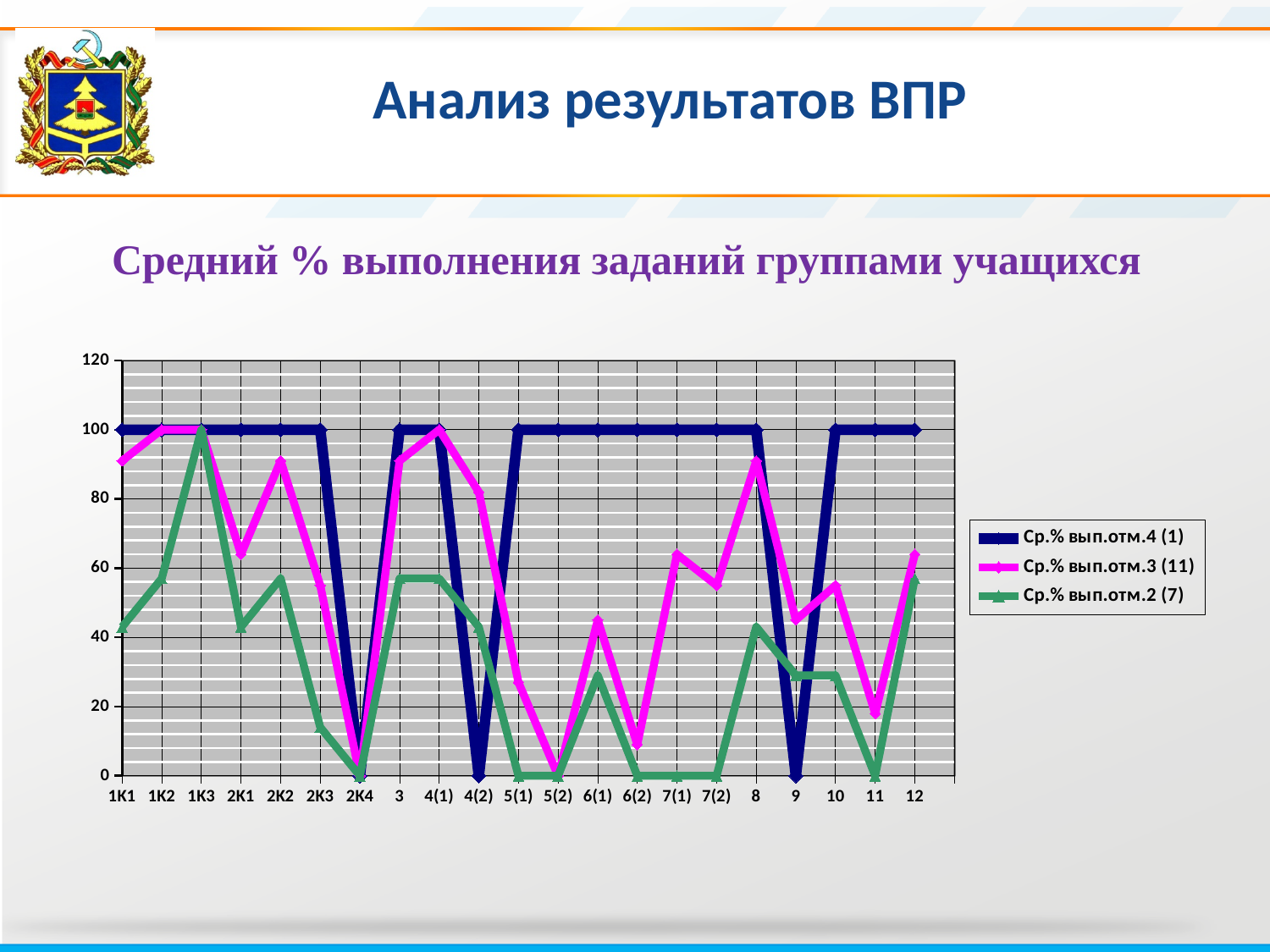
At 2К1, which series has the larger value: Ср.% вып.отм.3 (11) or Ср.% вып.отм.2 (7)? Ср.% вып.отм.3 (11) What is the value of Ср.% вып.отм.2 (7) at 2К4? 0 What is the value of Ср.% вып.отм.4 (1) at 9? 0 How many series does the legend list? 3 What is the title shown above the chart? Средний % выполнения заданий группами учащихся Is the value of Ср.% вып.отм.2 (7) at 8 greater or less than 60? less What is the value of Ср.% вып.отм.4 (1) at 1К1? 100 What is the value of Ср.% вып.отм.3 (11) at 1К3? 100 What kind of chart is shown on the slide? line chart Is the value of Ср.% вып.отм.3 (11) at 1К1 greater or less than 80? greater How many categories are shown on the x axis? 21 At 7(1), which series has the larger value: Ср.% вып.отм.3 (11) or Ср.% вып.отм.2 (7)? Ср.% вып.отм.3 (11)